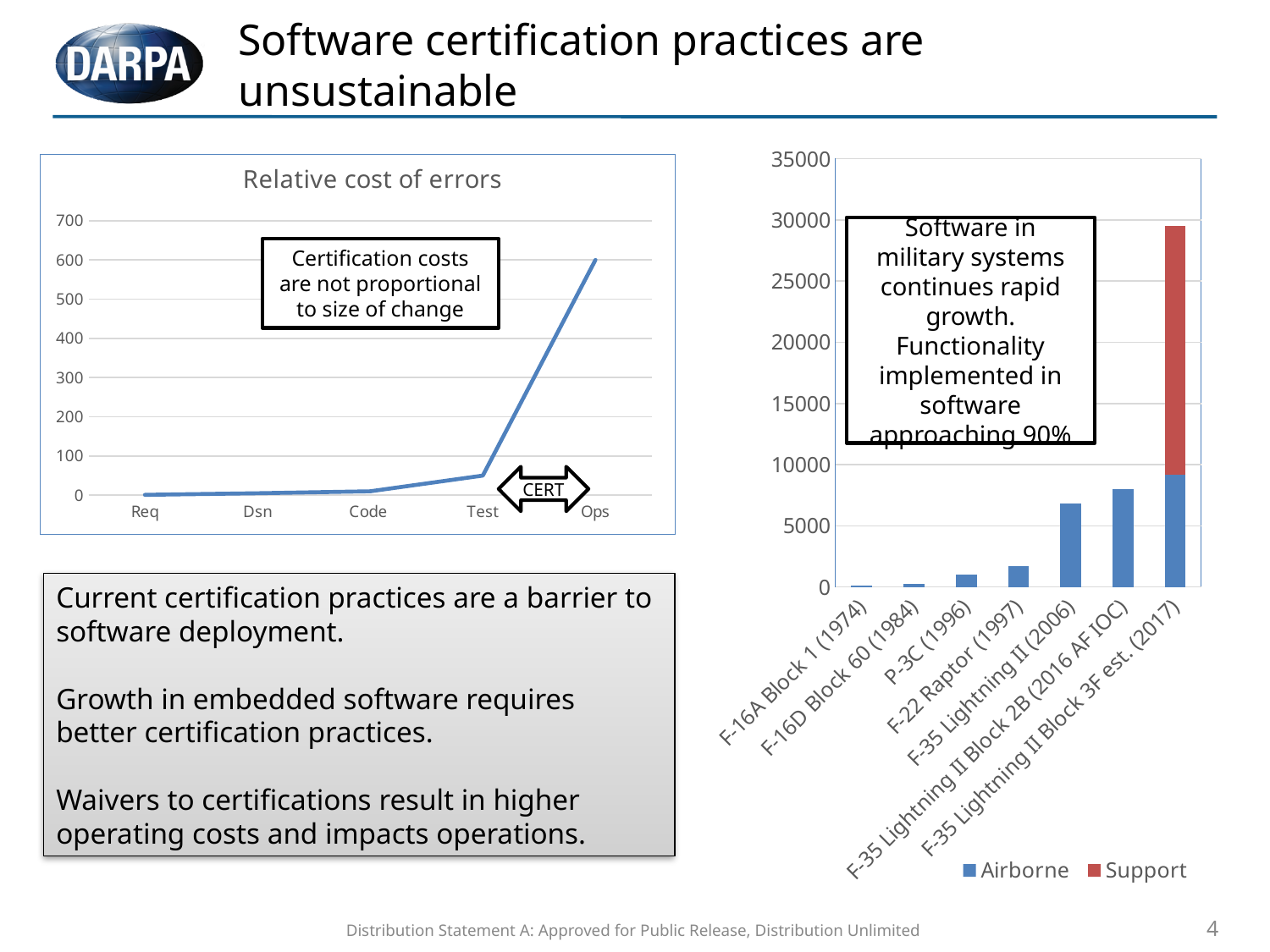
How many categories are shown on the x axis of the right-hand bar chart? 7 How many series does the legend of the right-hand bar chart list? 2 In the 'Relative cost of errors' chart, is the value for Test greater or less than 100? less What kind of chart is the 'Relative cost of errors' chart on the left? line chart What are the two series named in the legend of the right-hand bar chart? Airborne and Support In the 'Relative cost of errors' chart, what is the value for Ops? 600 In the right-hand bar chart, is the Airborne value for F-35 Lightning II Block 2B (2016 AF IOC) greater or less than 5000? greater What kind of chart is the chart on the right of the slide? bar chart How many categories are shown on the x axis of the 'Relative cost of errors' chart? 5 In the 'Relative cost of errors' chart, do the values rise or fall from Req to Ops? rise In the right-hand bar chart, which category has the tallest bar? F-35 Lightning II Block 3F est. (2017) In the 'Relative cost of errors' chart, which category has the highest value? Ops